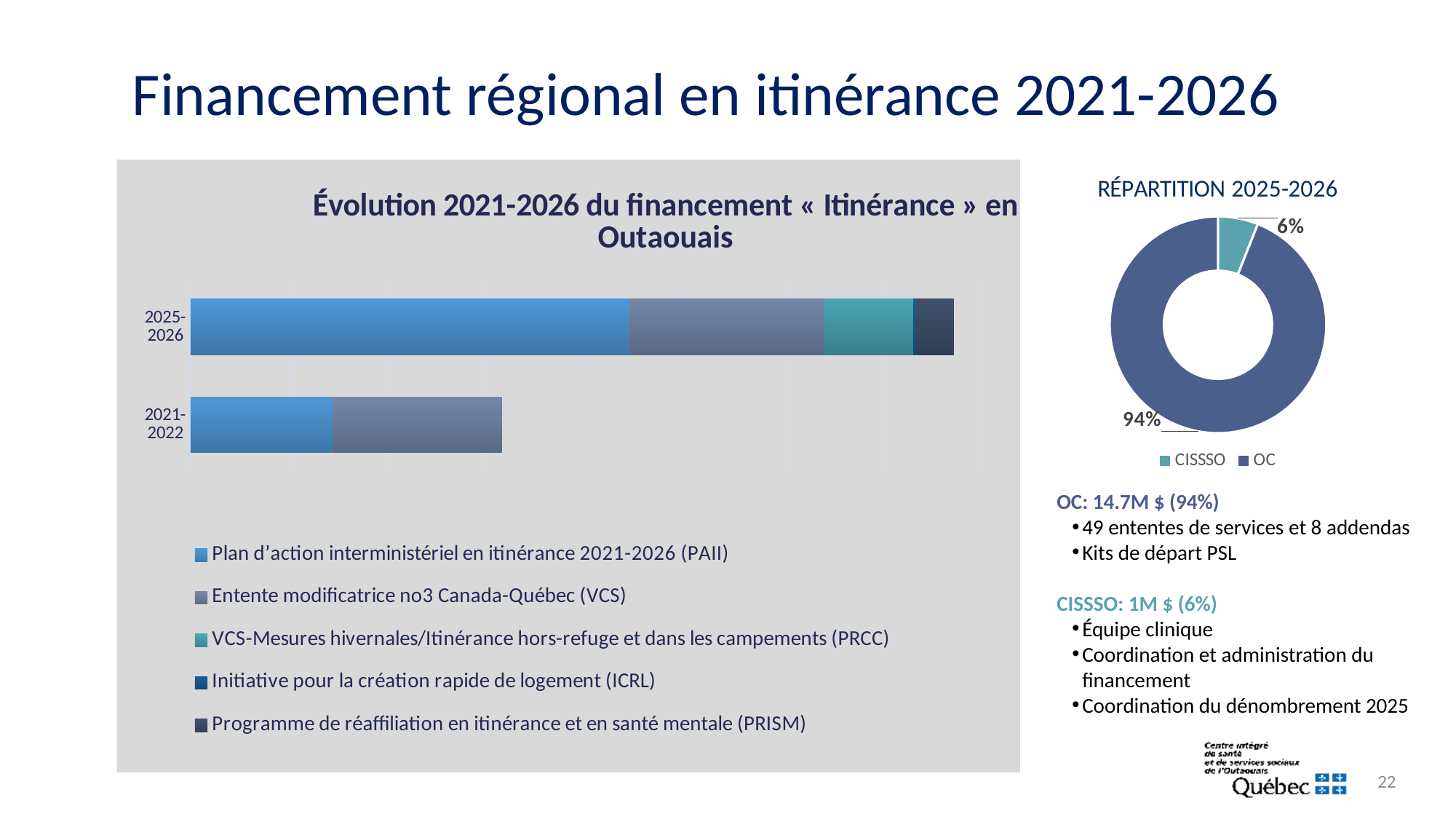
What kind of chart is the "Évolution 2021-2026 du financement « Itinérance » en Outaouais" chart? Stacked bar chart In the "Évolution 2021-2026 du financement « Itinérance » en Outaouais" chart, which series forms the largest segment of the 2025-2026 bar? Plan d'action interministériel en itinérance 2021-2026 (PAII) In the "Évolution 2021-2026 du financement « Itinérance » en Outaouais" chart, which period has the longer total bar, 2021-2022 or 2025-2026? 2025-2026 How many categories (years) are shown on the "Évolution 2021-2026 du financement « Itinérance » en Outaouais" chart? 2 In the "RÉPARTITION 2025-2026" chart, what share does CISSSO have? 6% In the "RÉPARTITION 2025-2026" chart, which slice is the largest? OC What kind of chart is the "RÉPARTITION 2025-2026" chart? Doughnut (pie) chart In the "RÉPARTITION 2025-2026" chart, what is the difference in percentage points between the OC share and the CISSSO share? 88 percentage points In the "Évolution 2021-2026 du financement « Itinérance » en Outaouais" chart, how many segments make up the 2021-2022 bar? 2 In the "RÉPARTITION 2025-2026" chart, what share does OC have? 94% How many series does the legend of the "Évolution 2021-2026 du financement « Itinérance » en Outaouais" chart list? 5 Does the total funding in the "Évolution 2021-2026 du financement « Itinérance » en Outaouais" chart rise or fall from 2021-2022 to 2025-2026? Rise